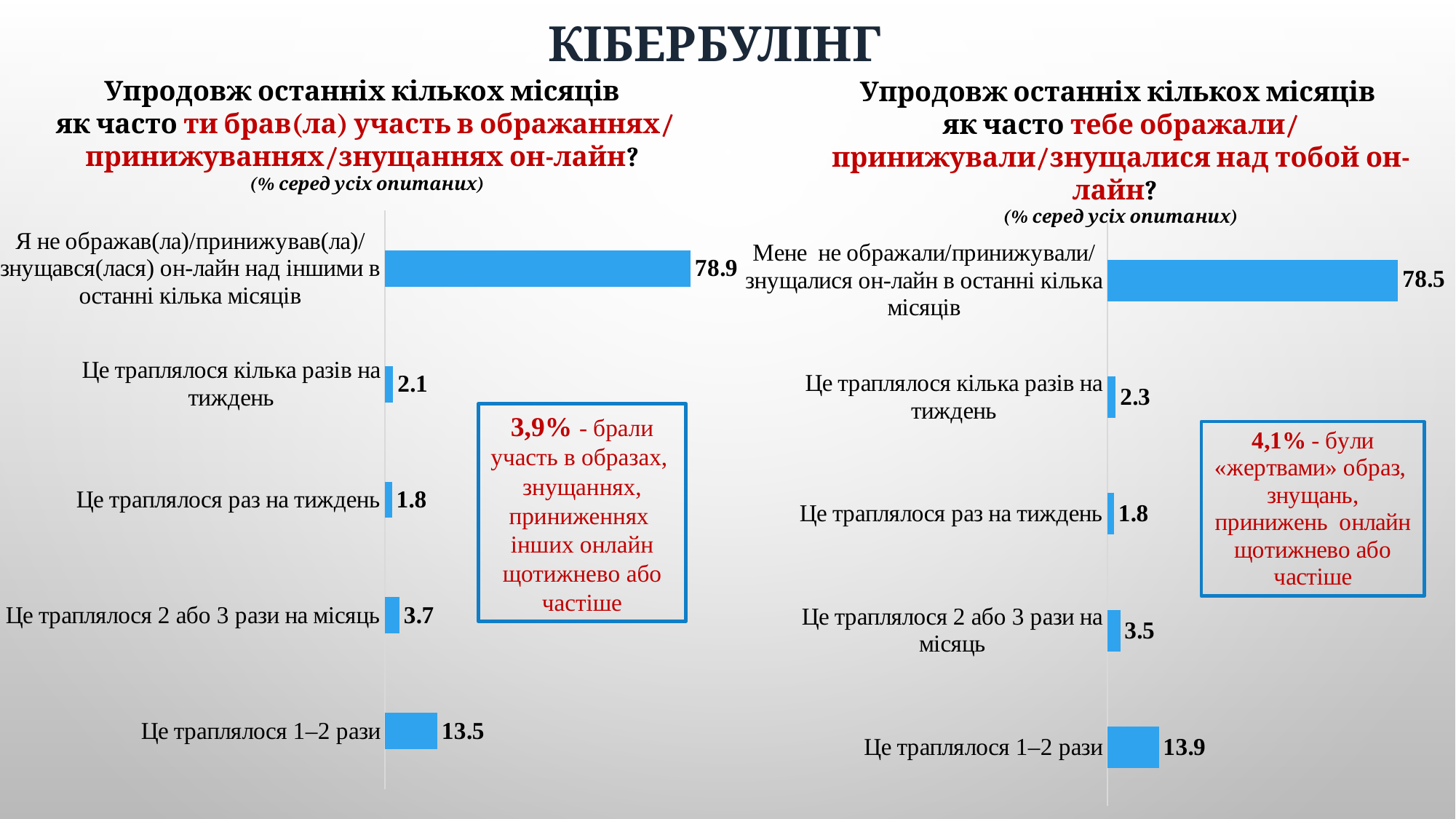
In the left chart, what is the difference between the values for "Це траплялося 2 або 3 рази на місяць" and "Це траплялося кілька разів на тиждень"? 1.6 How many categories does the left chart show? 5 In the left chart, what is the value for "Це траплялося 1–2 рази"? 13.5 In the right chart, what is the value for "Це траплялося 2 або 3 рази на місяць"? 3.5 Which is larger: the value for "Це траплялося 1–2 рази" in the left chart or in the right chart? Right chart (13.9) In the right chart, what is the value for "Це траплялося кілька разів на тиждень"? 2.3 What type of chart is the right chart? Bar chart In the left chart, which category has the lowest value? Це траплялося раз на тиждень In the right chart, what is the difference between the values for "Це траплялося 1–2 рази" and "Це траплялося 2 або 3 рази на місяць"? 10.4 What percentage is highlighted in the red text box on the right chart? 4,1% In the left chart, which category has the highest value? Я не ображав(ла)/принижував(ла)/знущався(лася) он-лайн над іншими в останні кілька місяців In the right chart, which category has the lowest value? Це траплялося раз на тиждень